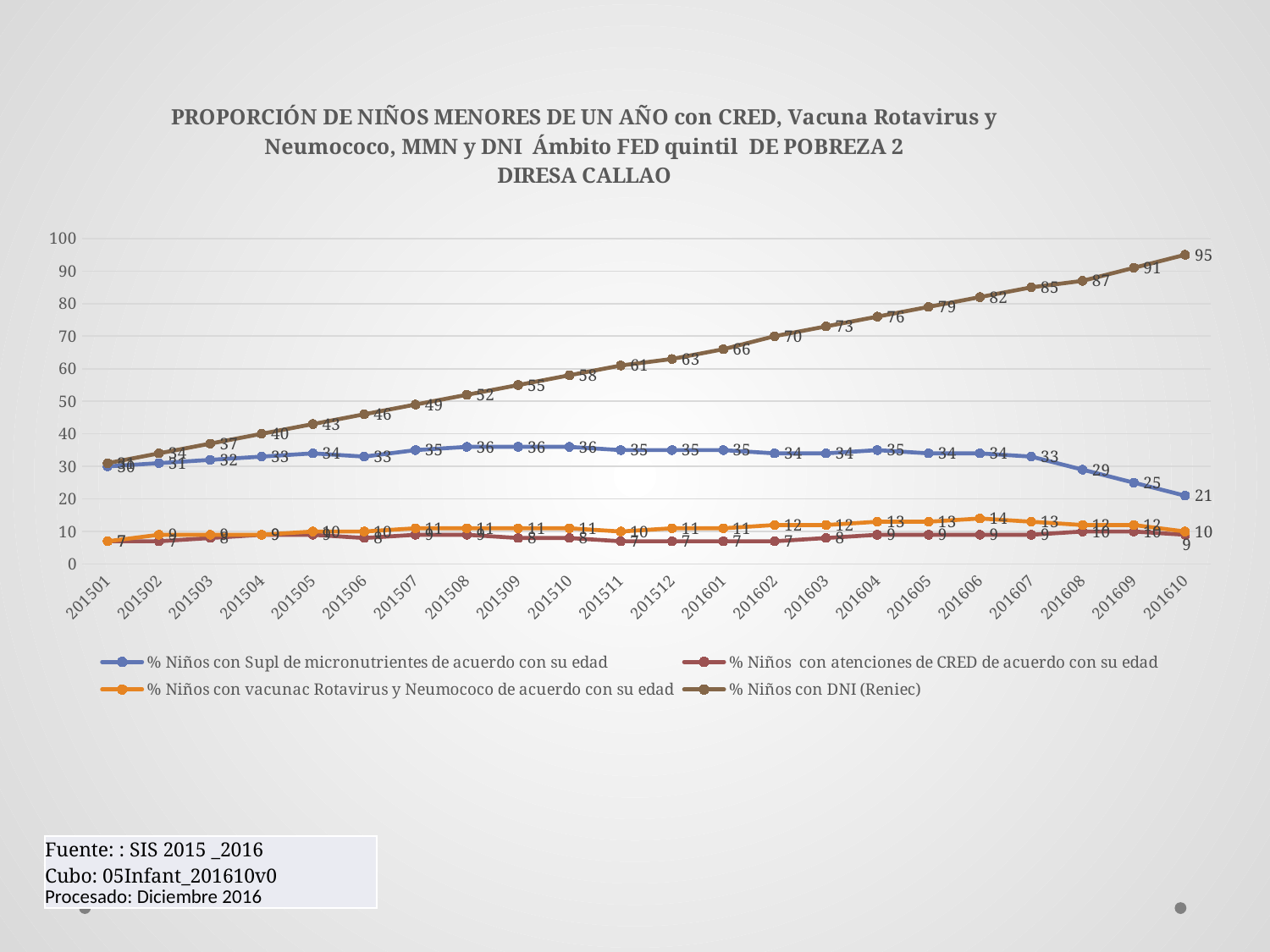
Does the % Niños con DNI (Reniec) series rise or fall from 201501 to 201610? rise Is the value for % Niños con DNI (Reniec) at 201601 greater or less than 60? greater How many months are plotted along the x axis? 22 What kind of chart is shown on the slide? line chart What is the value of % Niños con Supl de micronutrientes de acuerdo con su edad at 201610? 21 What is the difference between the % Niños con DNI (Reniec) value at 201610 and at 201501? 64 In which month does % Niños con DNI (Reniec) reach its highest value? 201610 At 201610, which is larger: % Niños con DNI (Reniec) or % Niños con Supl de micronutrientes de acuerdo con su edad? % Niños con DNI (Reniec) What is the value of % Niños con vacunac Rotavirus y Neumococo de acuerdo con su edad at 201606? 14 What is the value of % Niños con DNI (Reniec) at 201610? 95 How many series does the legend list? 4 Which DIRESA is named in the chart title? DIRESA CALLAO